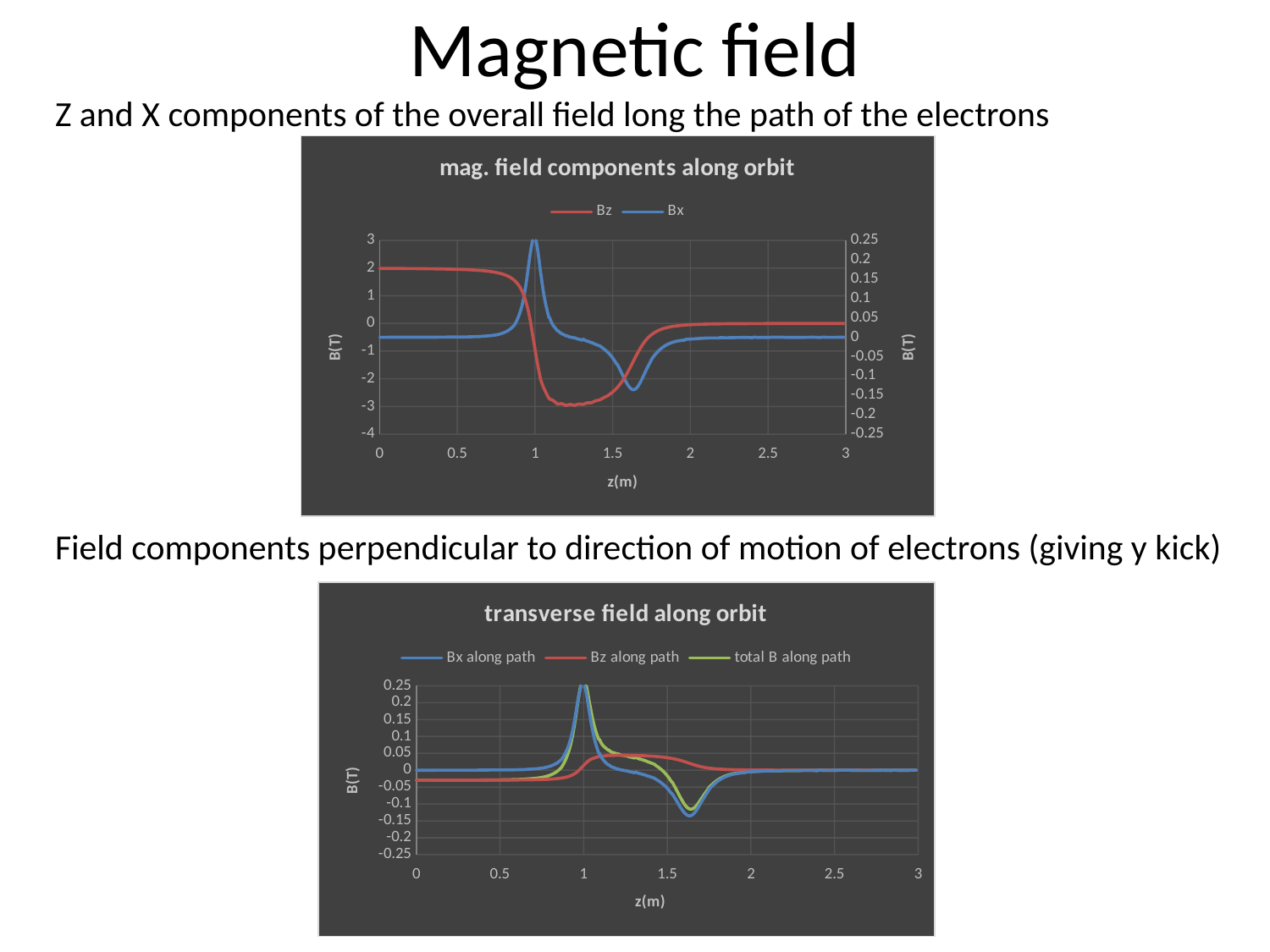
In the top chart "mag. field components along orbit", is the value of Bz at z = 0 on the left axis greater or less than 1? greater In the bottom chart "transverse field along orbit", which series is drawn in green? total B along path How many series does the legend of the bottom chart "transverse field along orbit" list? 3 In the top chart "mag. field components along orbit", is the minimum value of Bz (near z = 1.2) on the left axis greater or less than -2? less How many series does the legend of the top chart "mag. field components along orbit" list? 2 In the bottom chart "transverse field along orbit", is the value of Bz along path at z = 0 greater or less than 0? less What kind of chart is the top chart titled "mag. field components along orbit"? line chart In the bottom chart "transverse field along orbit", does Bx along path rise or fall between z = 1 and z = 1.6? fall In the top chart "mag. field components along orbit", does Bz rise or fall between z = 0.5 and z = 1.2? fall What is the x-axis label of the top chart "mag. field components along orbit"? z(m)